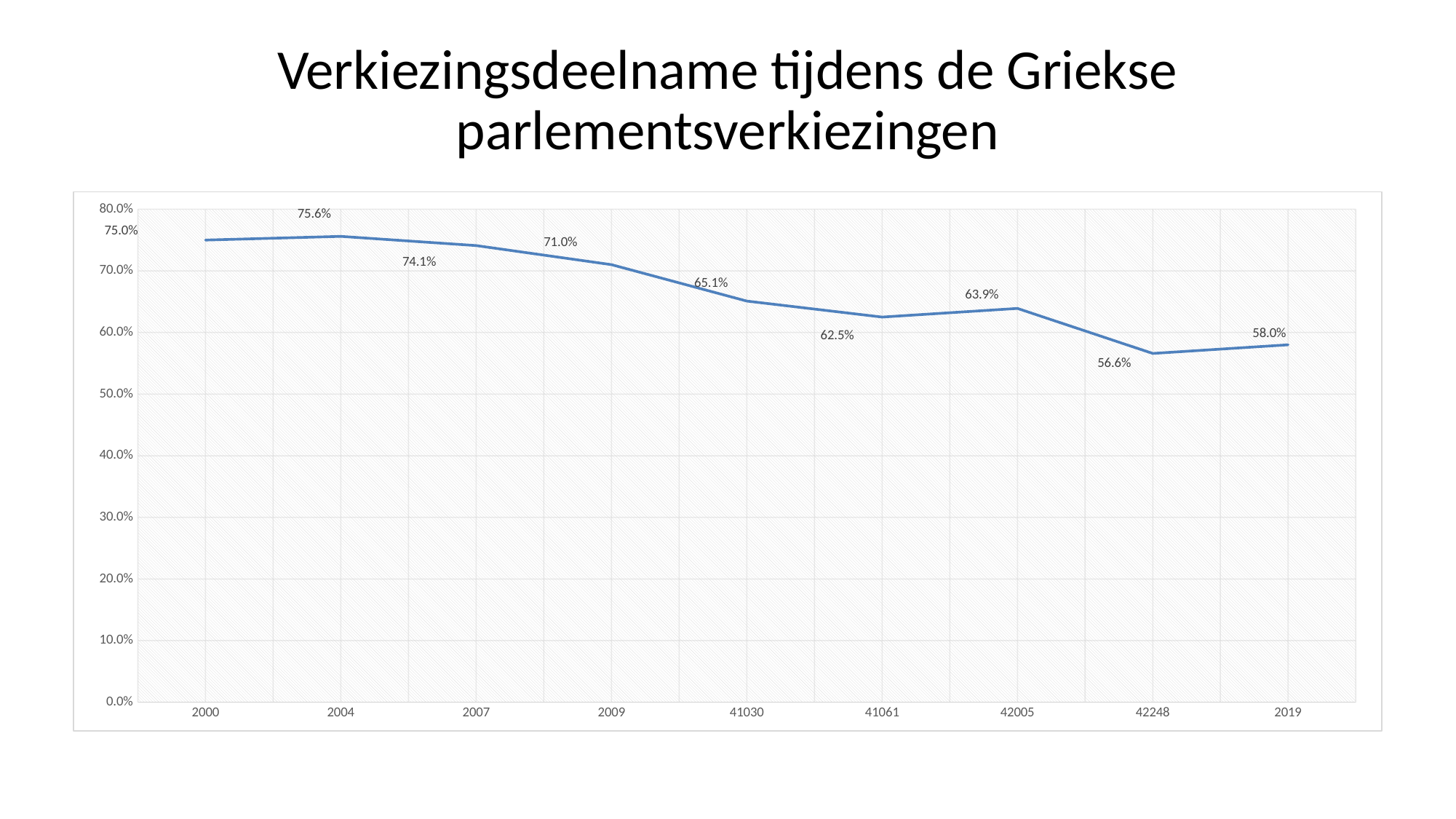
What is the value for 42248? 56.6% What is the value for 2009? 71.0% Which is larger, the value for 41061 or the value for 42005? 42005 What kind of chart is shown on the slide? line chart What is the value for 2019? 58.0% How many data points are plotted on the chart? 9 Which category has the lowest value? 42248 Is the value for 41030 greater or less than 70.0%? less What is the value for 2004? 75.6% What is the difference between the values for 2004 and 2019? 17.6% Which category has the highest value? 2004 Do the values generally rise or fall from left to right along the x axis? fall